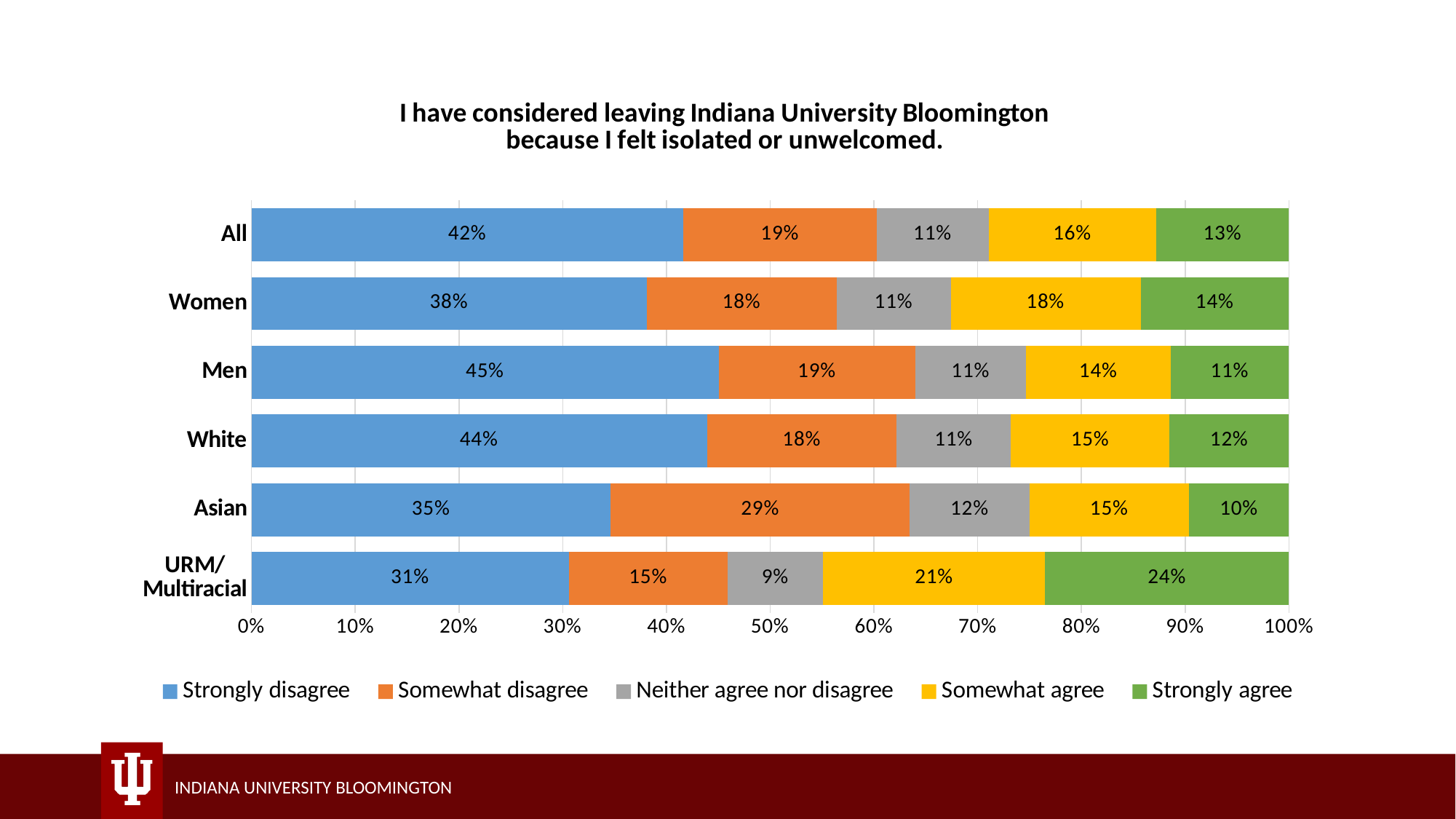
Which colour represents Somewhat agree in the chart? Yellow What percentage of the URM/Multiracial group strongly agree? 24% What kind of chart is shown on the slide? Stacked bar chart How many groups (categories) are shown on the y axis? 6 Which group has the highest Strongly disagree percentage? Men What is the Somewhat disagree value for the Asian group? 29% How many series does the legend list? 5 What is the Somewhat agree value for Women? 18% Which is larger: the Strongly disagree value for White or for Asian? White What percentage of Men strongly disagree that they have considered leaving Indiana University Bloomington because they felt isolated or unwelcomed? 45% Which group has the lowest Neither agree nor disagree percentage? URM/Multiracial What is the difference between the Strongly agree values for URM/Multiracial and Asian? 14%